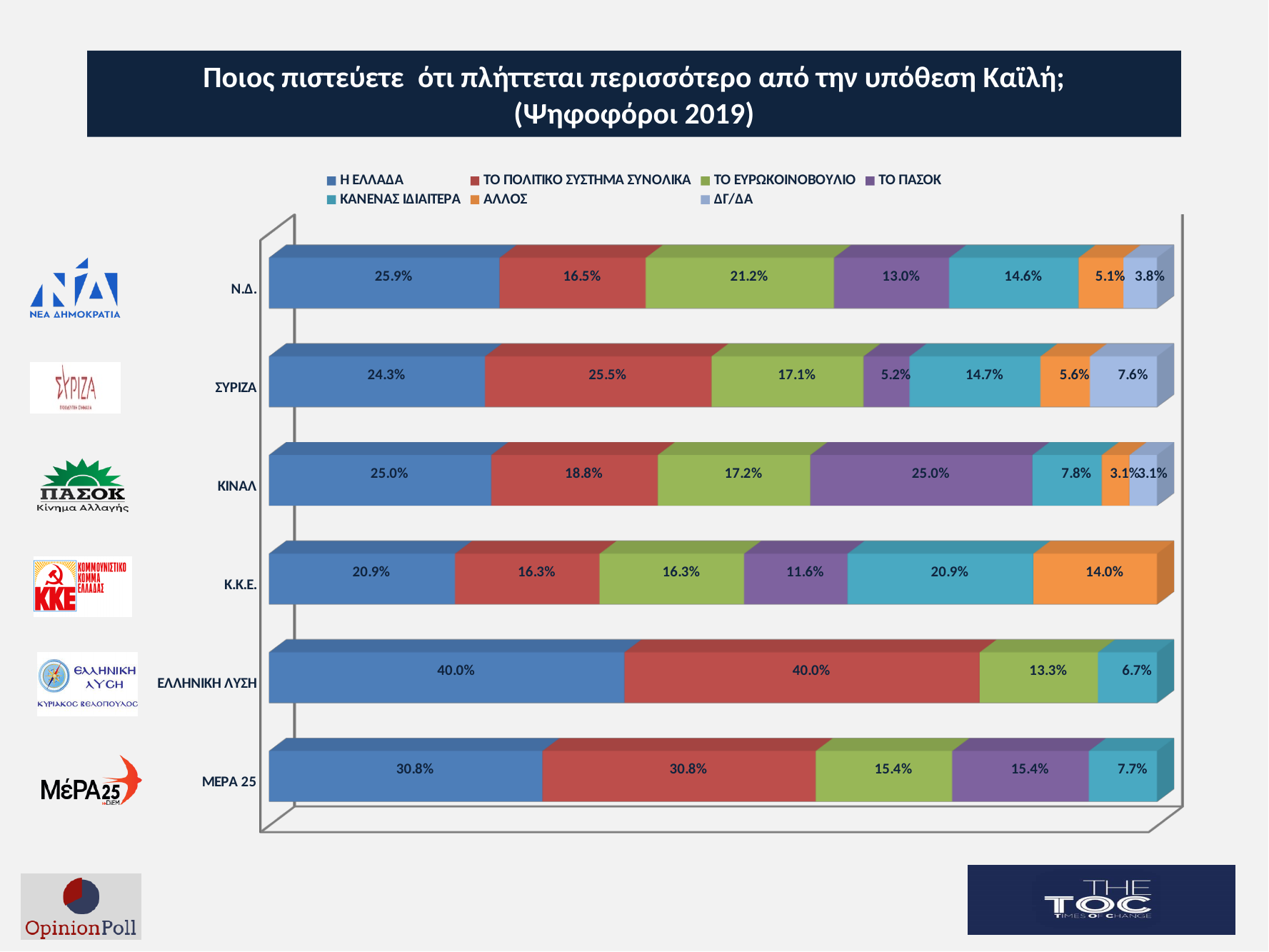
Which is larger: the ΔΓ/ΔΑ value for ΣΥΡΙΖΑ voters or for Ν.Δ. voters? ΣΥΡΙΖΑ How many series does the legend list? 7 How many voter groups (categories) are plotted on the chart? 6 What kind of chart is shown on the slide? stacked bar chart What is the value for ΤΟ ΠΟΛΙΤΙΚΟ ΣΥΣΤΗΜΑ ΣΥΝΟΛΙΚΑ among ΣΥΡΙΖΑ voters? 25.5% Which voter group has the lowest value for ΤΟ ΕΥΡΩΚΟΙΝΟΒΟΥΛΙΟ? ΕΛΛΗΝΙΚΗ ΛΥΣΗ What is the value for Η ΕΛΛΑΔΑ among Ν.Δ. voters? 25.9% What colour represents ΤΟ ΠΟΛΙΤΙΚΟ ΣΥΣΤΗΜΑ ΣΥΝΟΛΙΚΑ in the legend? red What is the difference between the ΤΟ ΕΥΡΩΚΟΙΝΟΒΟΥΛΙΟ value for Ν.Δ. voters and for ΣΥΡΙΖΑ voters? 4.1% What is the value for ΤΟ ΠΑΣΟΚ among ΚΙΝΑΛ voters? 25.0% What is the value for ΑΛΛΟΣ among Κ.Κ.Ε. voters? 14.0% Which voter group has the highest value for Η ΕΛΛΑΔΑ? ΕΛΛΗΝΙΚΗ ΛΥΣΗ